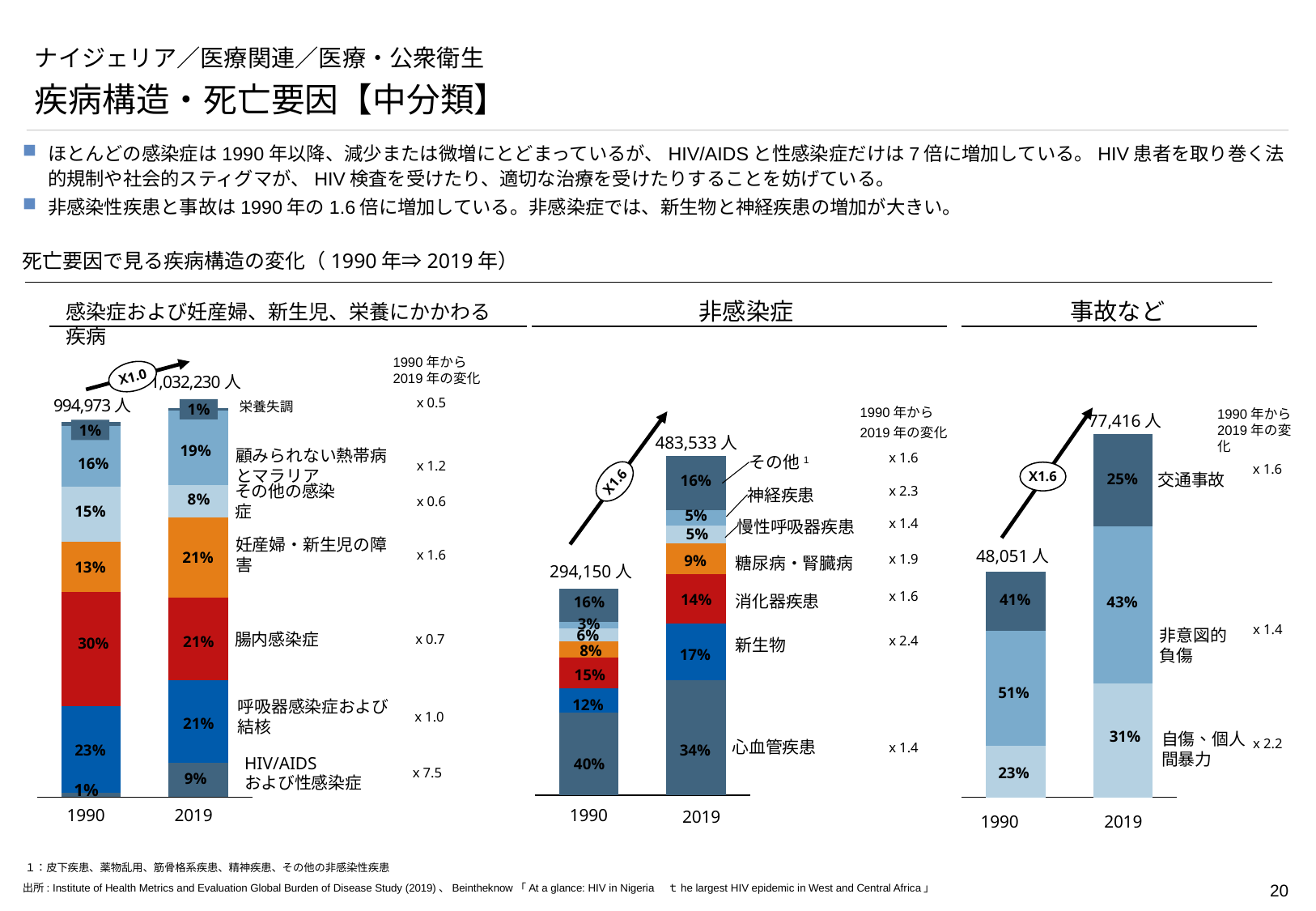
「感染症および妊産婦、新生児、栄養にかかわる疾病」のグラフで、2019年の棒の中で最も割合が小さい項目は何ですか？ 栄養失調 「事故など」のグラフで、2019年の合計死亡者数はいくらですか？ 77,416人 このスライドのグラフはどの種類のグラフですか？ 積み上げ棒グラフ 「事故など」のグラフで、2019年の非意図的負傷と自傷、個人間暴力では、どちらの割合が大きいですか？ 非意図的負傷 「感染症および妊産婦、新生児、栄養にかかわる疾病」のグラフで、1990年の腸内感染症の割合はいくらですか？ 30% 「感染症および妊産婦、新生児、栄養にかかわる疾病」のグラフで、1990年の腸内感染症と呼吸器感染症および結核の割合の差はいくらですか？ 7% 「感染症および妊産婦、新生児、栄養にかかわる疾病」のグラフで、HIV/AIDSおよび性感染症の1990年から2019年の変化は何倍ですか？ x 7.5 「非感染症」のグラフで、2019年の新生物の割合はいくらですか？ 17% 「非感染症」のグラフで、2019年の棒の中で最も割合が大きい項目は何ですか？ 心血管疾患 「非感染症」のグラフで、1990年の合計死亡者数はいくらですか？ 294,150人 「非感染症」のグラフで、神経疾患の1990年から2019年の変化は何倍ですか？ x 2.3 「感染症および妊産婦、新生児、栄養にかかわる疾病」のグラフで、2019年の合計死亡者数はいくらですか？ 1,032,230人